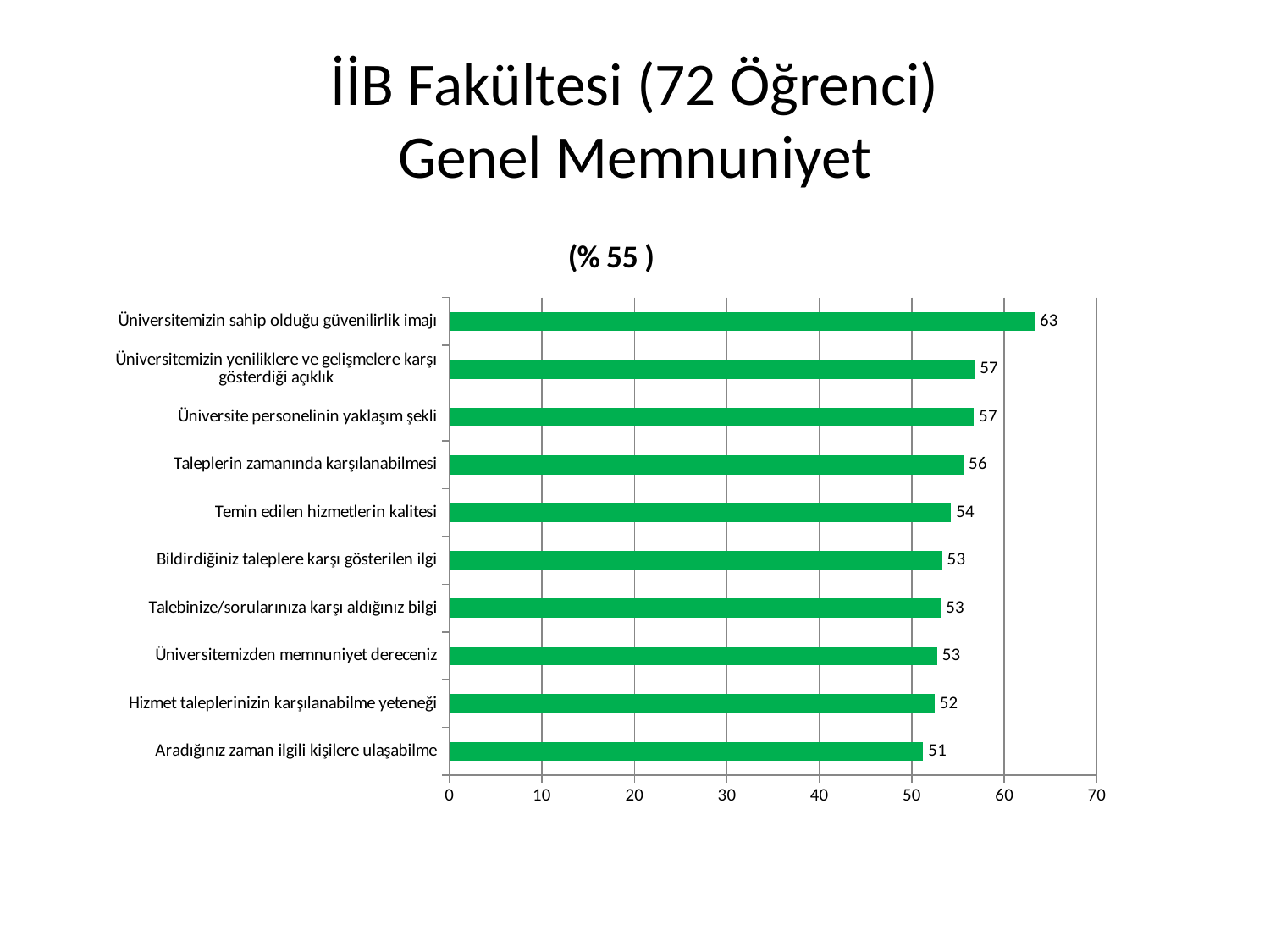
How many categories are shown in the chart? 10 What is the value for "Taleplerin zamanında karşılanabilmesi"? 56 What is the value for "Üniversitemizin sahip olduğu güvenilirlik imajı"? 63 What is the value for "Aradığınız zaman ilgili kişilere ulaşabilme"? 51 Which category has the lowest value? Aradığınız zaman ilgili kişilere ulaşabilme Is the value for "Üniversite personelinin yaklaşım şekli" greater or less than 50? greater What is the title of the chart? (% 55 ) What is the difference between the values for "Üniversitemizin sahip olduğu güvenilirlik imajı" and "Aradığınız zaman ilgili kişilere ulaşabilme"? 12 Which is larger: the value for "Temin edilen hizmetlerin kalitesi" or the value for "Hizmet taleplerinizin karşılanabilme yeteneği"? Temin edilen hizmetlerin kalitesi What is the value for "Hizmet taleplerinizin karşılanabilme yeteneği"? 52 What kind of chart is shown on the slide? bar chart Which category has the highest value? Üniversitemizin sahip olduğu güvenilirlik imajı